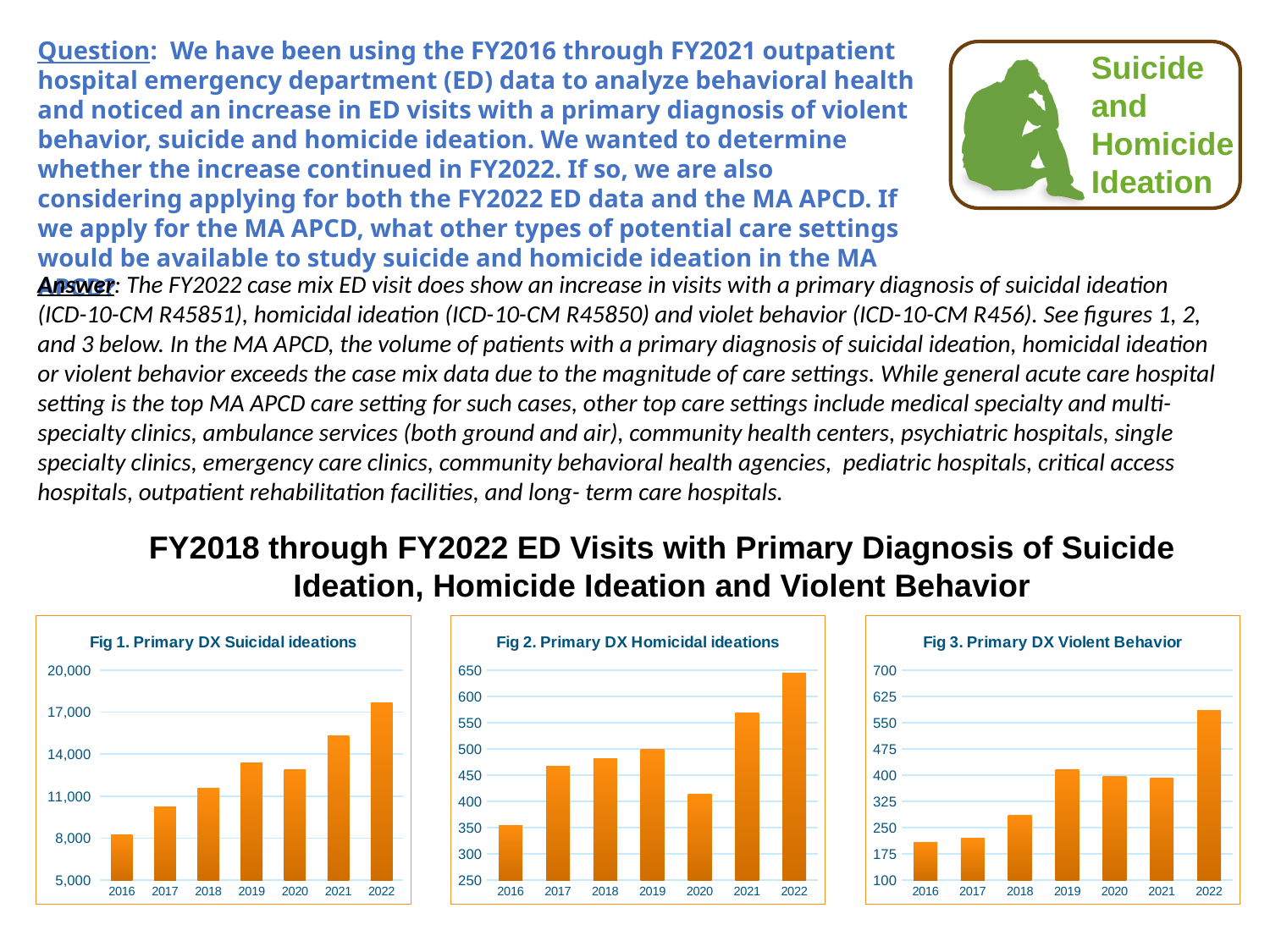
What kind of chart is Fig 2. Primary DX Homicidal ideations? bar chart In Fig 3. Primary DX Violent Behavior, which year has the lowest value? 2016 In Fig 2. Primary DX Homicidal ideations, is the value for 2022 greater or less than 600? greater In Fig 3. Primary DX Violent Behavior, is the value for 2022 greater or less than 550? greater In Fig 1. Primary DX Suicidal ideations, is the value for 2022 greater or less than 17,000? greater In Fig 2. Primary DX Homicidal ideations, which is larger, the value for 2019 or the value for 2020? 2019 In Fig 1. Primary DX Suicidal ideations, which year has the lowest value? 2016 In Fig 1. Primary DX Suicidal ideations, which is larger, the value for 2020 or the value for 2021? 2021 How many years are shown on the x axis of Fig 3. Primary DX Violent Behavior? 7 In Fig 2. Primary DX Homicidal ideations, which year has the highest value? 2022 In Fig 1. Primary DX Suicidal ideations, which year has the highest value? 2022